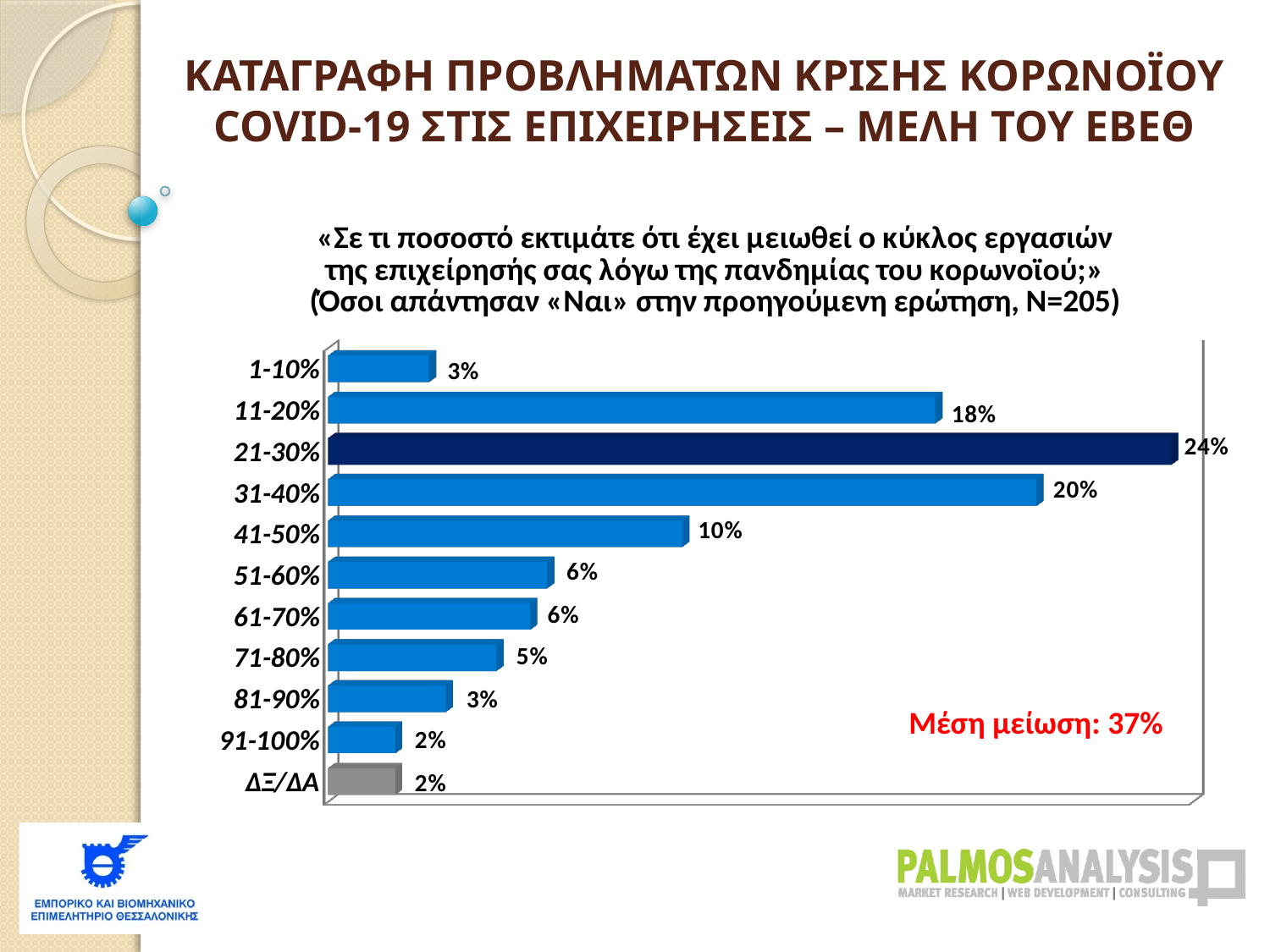
Which is larger, the value for 71-80% or the value for 81-90%? 71-80% What percentage of respondents estimated a turnover reduction of 21-30%? 24% Which is larger, the value for 31-40% or the value for 11-20%? 31-40% What is the difference between the values for 31-40% and 1-10%? 17% What kind of chart is shown on the slide? Bar chart What is the value shown for the 11-20% category? 18% Which category has the highest value? 21-30% What is the mean reduction (Μέση μείωση) stated on the slide? 37% What is the value shown for the ΔΞ/ΔΑ category? 2% How many categories are shown in the chart? 11 What is the value shown for the 41-50% category? 10% What is the difference between the values for 21-30% and 11-20%? 6%